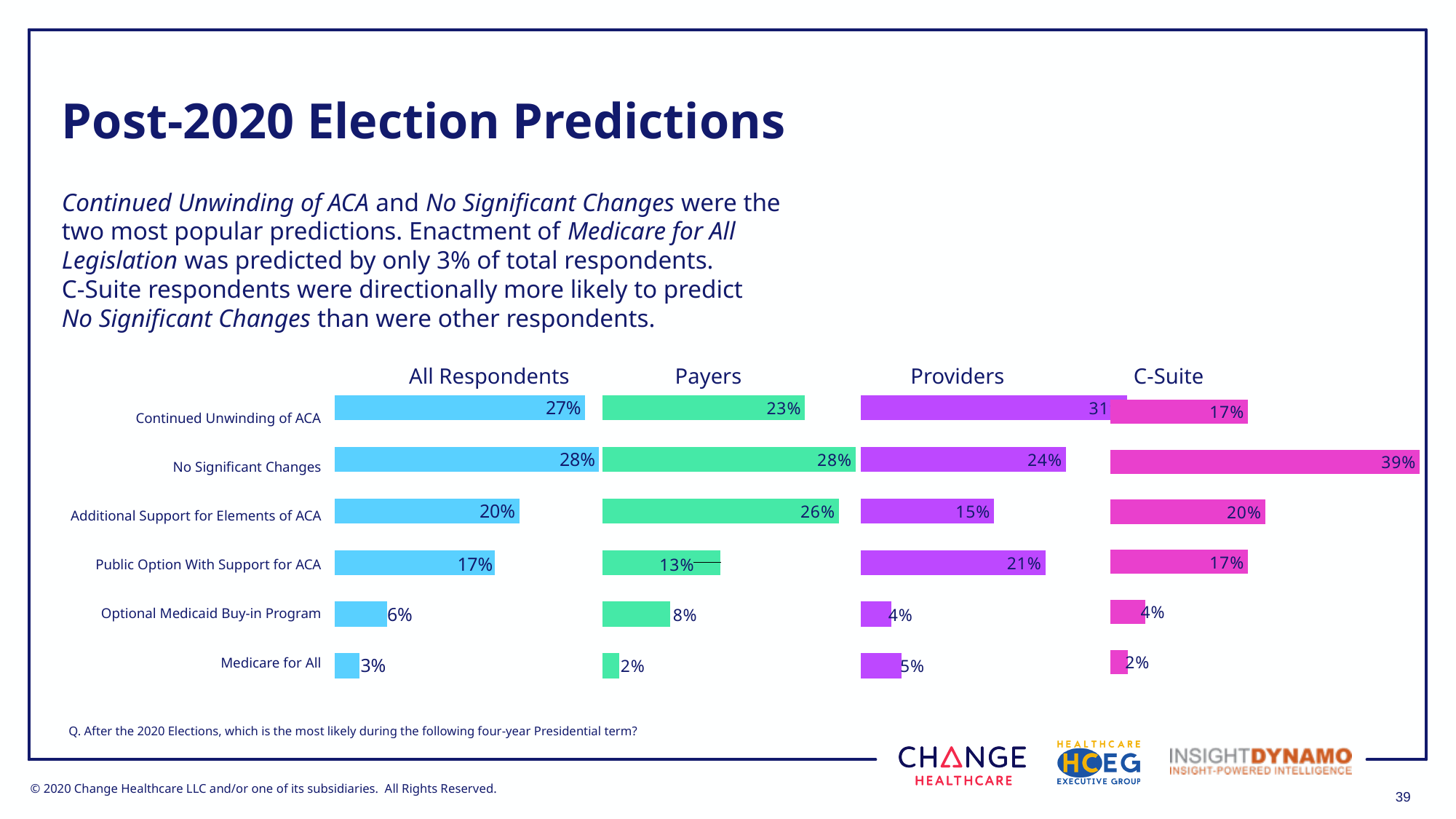
In the C-Suite chart, which category has the highest value? No Significant Changes How many categories are shown in the All Respondents chart? 6 How many respondent groups are charted on the slide? 4 In the C-Suite chart, what is the value for No Significant Changes? 39% In the All Respondents chart, what is the difference between No Significant Changes and Continued Unwinding of ACA? 1% In the Payers chart, what is the value for Additional Support for Elements of ACA? 26% In the Providers chart, which is larger: Public Option With Support for ACA or Additional Support for Elements of ACA? Public Option With Support for ACA In the Payers chart, which category has the lowest value? Medicare for All What kind of chart is used for the Payers data? Bar chart In the All Respondents chart, what is the value for No Significant Changes? 28% In the C-Suite chart, what is the difference between No Significant Changes and Additional Support for Elements of ACA? 19% In the Providers chart, what is the value for Public Option With Support for ACA? 21%